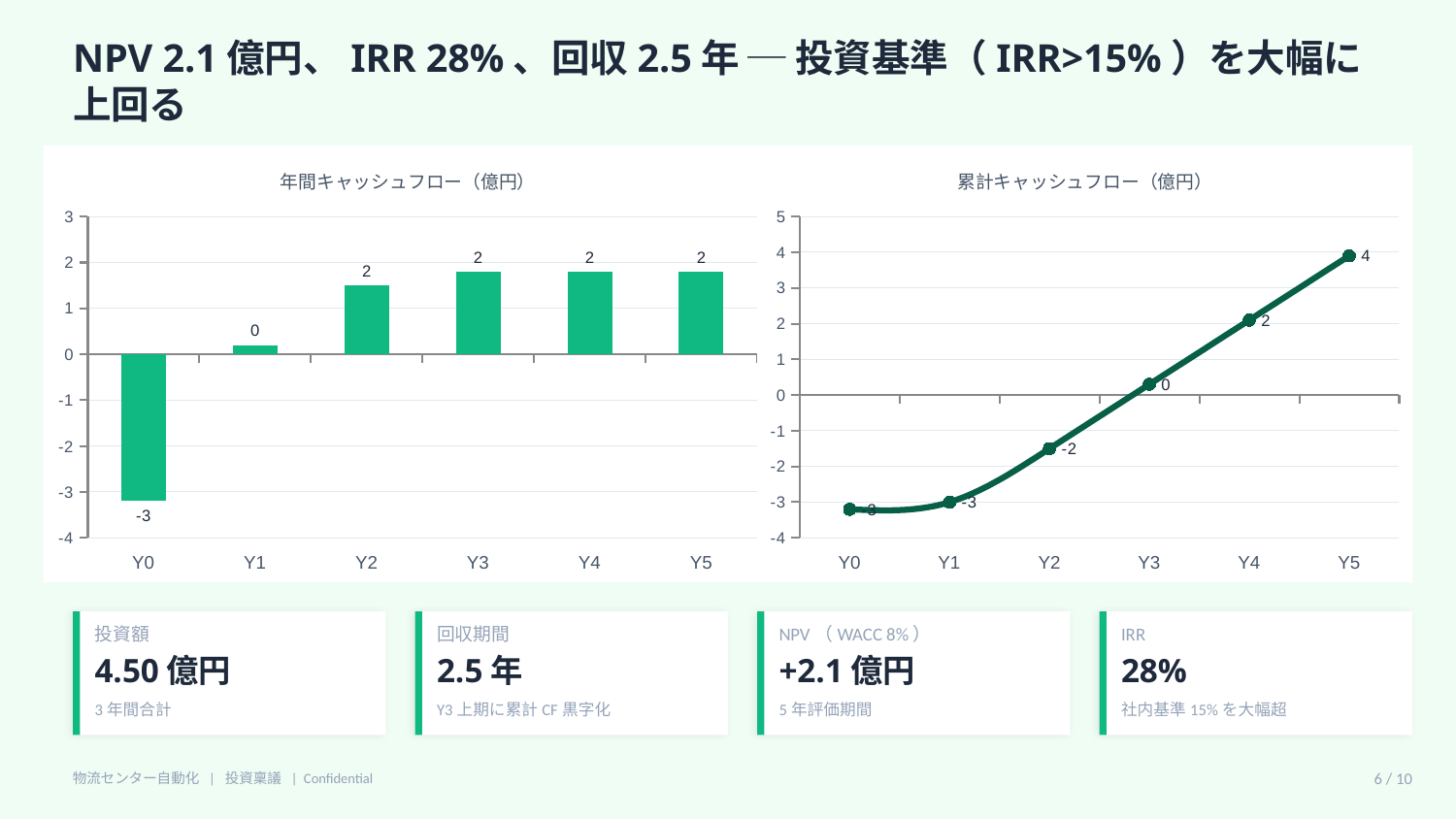
What kind of chart is the 累計キャッシュフロー（億円） chart on the right? line chart In the 年間キャッシュフロー（億円） chart, which year has the lowest value? Y0 In the 累計キャッシュフロー（億円） chart, what is the data label for Y5? 4 In the 累計キャッシュフロー（億円） chart, do the values rise or fall from Y0 to Y5? rise In the 年間キャッシュフロー（億円） chart, what is the data label for Y1? 0 In the 累計キャッシュフロー（億円） chart, which year has the highest value? Y5 In the 累計キャッシュフロー（億円） chart, is the value for Y4 greater or less than 1? greater What kind of chart is the 年間キャッシュフロー（億円） chart on the left? bar chart In the 年間キャッシュフロー（億円） chart, what is the data label for Y0? -3 In the 年間キャッシュフロー（億円） chart, which is larger, the value for Y0 or the value for Y3? Y3 How many categories are shown on the x axis of the 年間キャッシュフロー（億円） chart? 6 In the 累計キャッシュフロー（億円） chart, what is the data label for Y2? -2